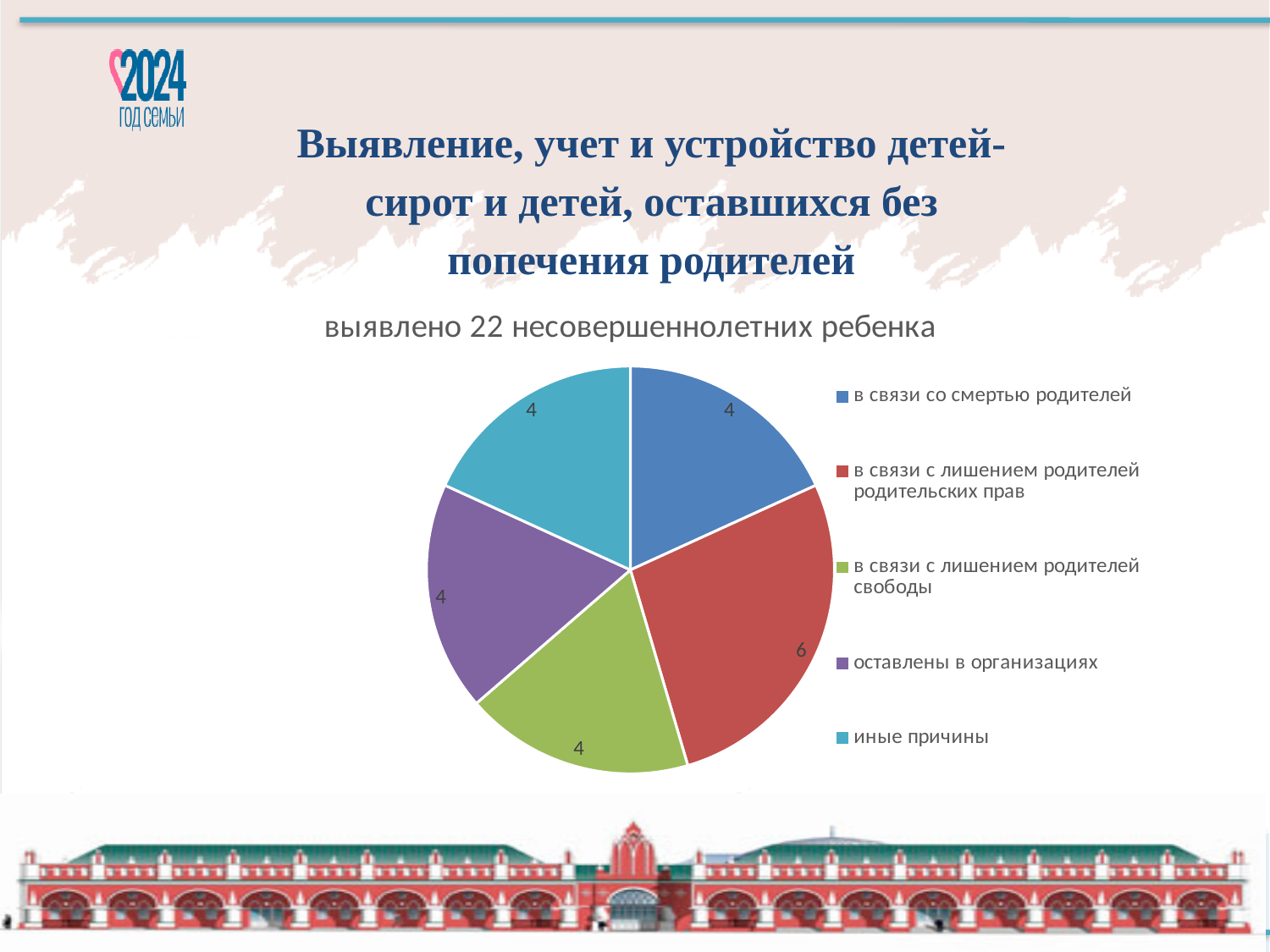
How many slices does the pie chart have? 5 Which category has the largest slice of the pie? в связи с лишением родителей родительских прав How many entries does the legend list? 5 What is the difference between the value for "в связи с лишением родителей родительских прав" and the value for "в связи с лишением родителей свободы"? 2 What is the value for "иные причины"? 4 What is the value for "в связи с лишением родителей родительских прав"? 6 What is the total of all slices in the pie chart? 22 What is the value for "оставлены в организациях"? 4 Which colour represents "иные причины" in the legend? light blue (cyan) Which is larger: the value for "в связи с лишением родителей родительских прав" or the value for "оставлены в организациях"? в связи с лишением родителей родительских прав What type of chart is shown on the slide? pie chart What is the value for "в связи со смертью родителей"? 4